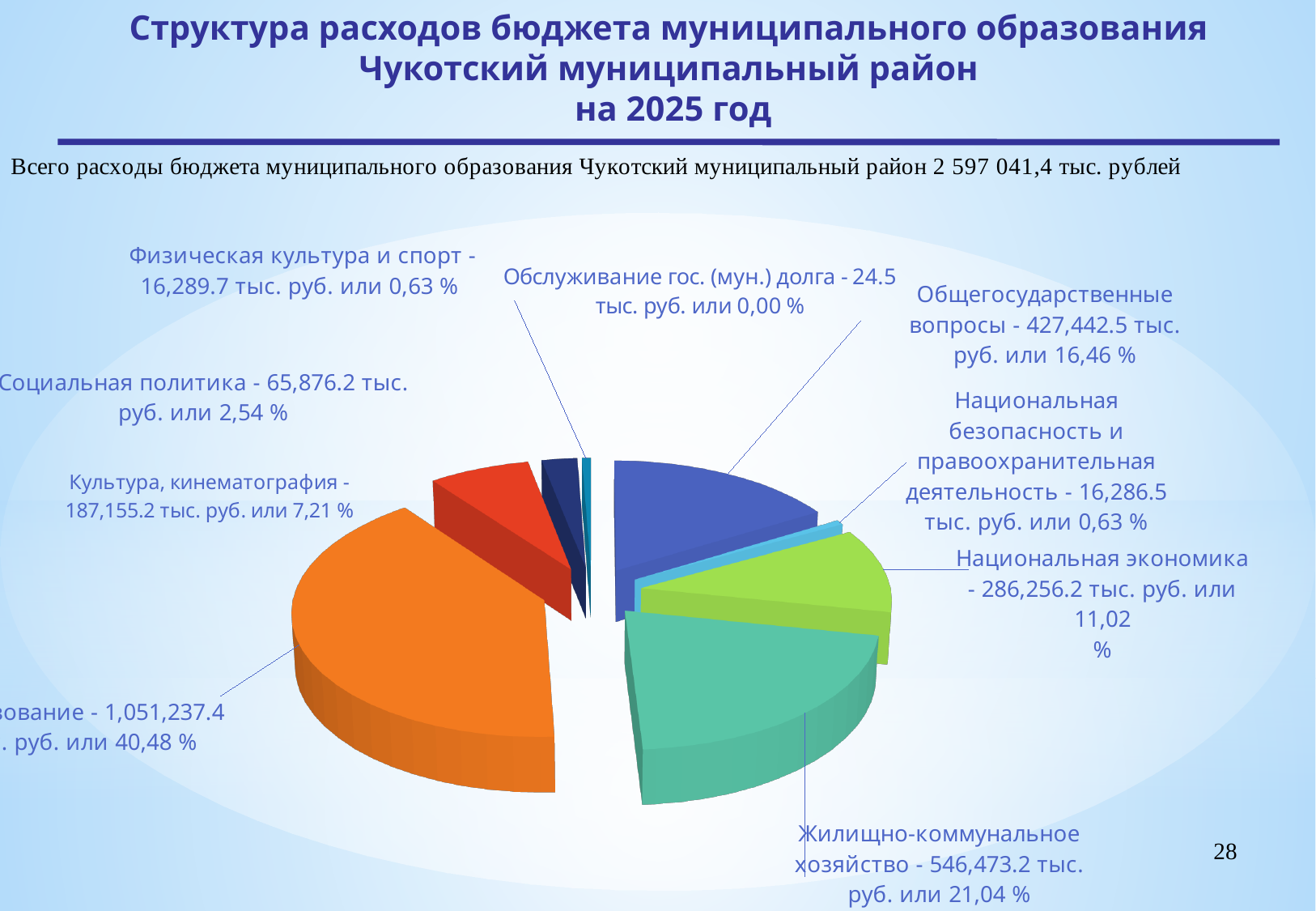
What is the amount for Жилищно-коммунальное хозяйство? 546,473.2 тыс. руб. How many expenditure categories are shown in the pie chart? 9 Which is larger: the amount for Социальная политика or for Культура, кинематография? Культура, кинематография What is the difference in amount between Жилищно-коммунальное хозяйство and Общегосударственные вопросы? 119,030.7 тыс. руб. What share of expenditure is Культура, кинематография? 7,21 % Which category has the smallest share of expenditure? Обслуживание гос. (мун.) долга What type of chart is shown on the slide? Pie chart What share of the budget expenditure goes to Общегосударственные вопросы? 16,46 % What is the difference in percentage share between Национальная экономика and Культура, кинематография? 3,81 % What is the amount for Национальная экономика? 286,256.2 тыс. руб. What total budget expenditure is stated on the slide? 2 597 041,4 тыс. рублей What is the combined amount for Физическая культура и спорт and Национальная безопасность и правоохранительная деятельность? 32,576.2 тыс. руб.